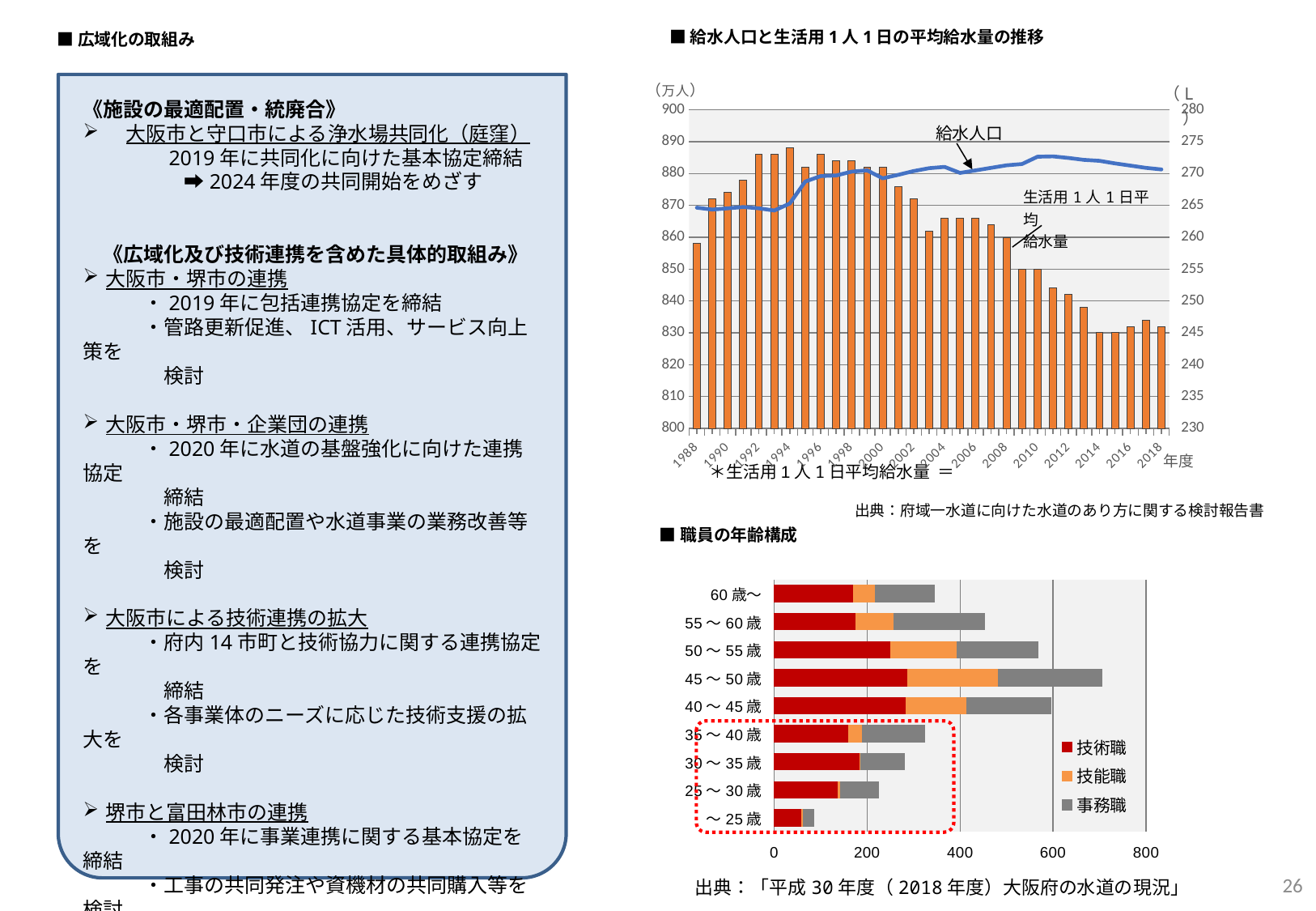
What kind of chart is the 職員の年齢構成 chart? bar chart In the 給水人口と生活用1人1日の平均給水量の推移 chart, how many years (bars) are plotted from 1988 to 2018? 31 In the 職員の年齢構成 chart, is the total for ～25歳 greater or less than 200? less In the 職員の年齢構成 chart, is the total for 45～50歳 greater or less than 600? greater In the 給水人口と生活用1人1日の平均給水量の推移 chart, which year has the tallest bar? 1994 In the 職員の年齢構成 chart, which series is shown in red? 技術職 In the 職員の年齢構成 chart, which age category has the shortest total bar? ～25歳 How many age categories are shown in the 職員の年齢構成 chart? 9 How many series does the legend of the 職員の年齢構成 chart list? 3 In the 給水人口と生活用1人1日の平均給水量の推移 chart, do the bars rise or fall from 1994 to 2018? fall In the 職員の年齢構成 chart, which age category has the longest total bar? 45～50歳 In the 職員の年齢構成 chart, which is larger, the total bar for 50～55歳 or for 60歳～? 50～55歳